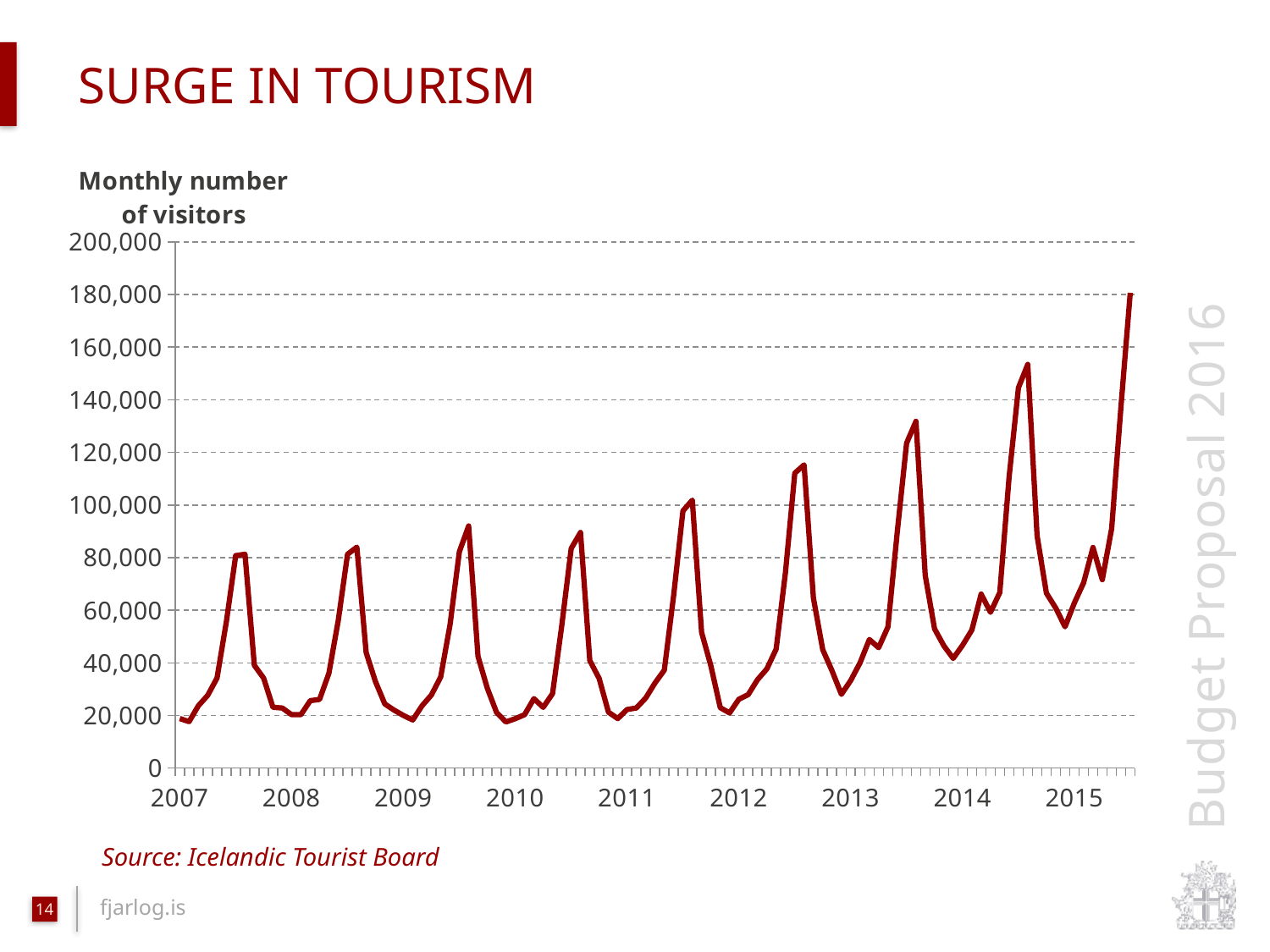
Is the peak monthly value in 2014 greater or less than 140,000? greater What is the highest value shown on the y axis? 200,000 How many year labels are shown on the x axis? 9 Which year's summer peak is higher, 2008 or 2014? 2014 What kind of chart is shown on the slide? line chart Is the last plotted value in 2015 greater or less than 160,000? greater What is the source cited for the chart? Icelandic Tourist Board Is the peak monthly value in 2009 greater or less than 100,000? less Overall, do the monthly visitor numbers rise or fall from 2007 to 2015? rise What is the title of the chart's vertical axis label? Monthly number of visitors